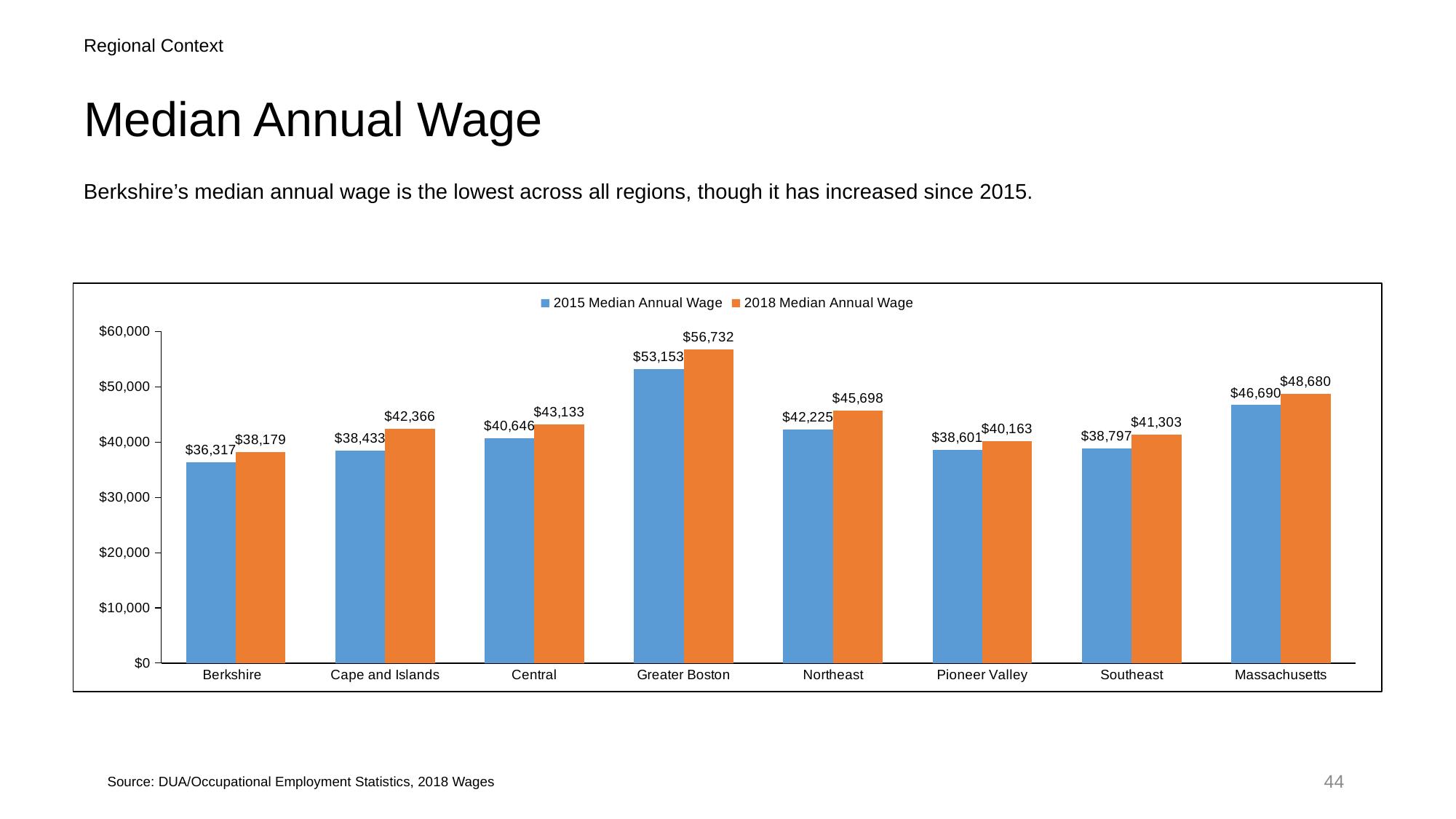
Which region has the highest 2018 Median Annual Wage? Greater Boston What kind of chart is shown on the slide? Bar chart How many regions are shown on the x axis of the chart? 8 What is the difference between the 2018 and 2015 Median Annual Wage for Berkshire? $1,862 What was the 2018 Median Annual Wage for Pioneer Valley? $40,163 How many series does the chart legend list? 2 Which is larger: the 2018 Median Annual Wage for Northeast or for Central? Northeast Which region has the lowest 2015 Median Annual Wage? Berkshire What is the difference between the 2018 Median Annual Wage for Massachusetts and for Berkshire? $10,501 What was the 2018 Median Annual Wage for Greater Boston? $56,732 Is the 2015 Median Annual Wage for Greater Boston greater or less than $50,000? greater What was the 2015 Median Annual Wage for Berkshire? $36,317